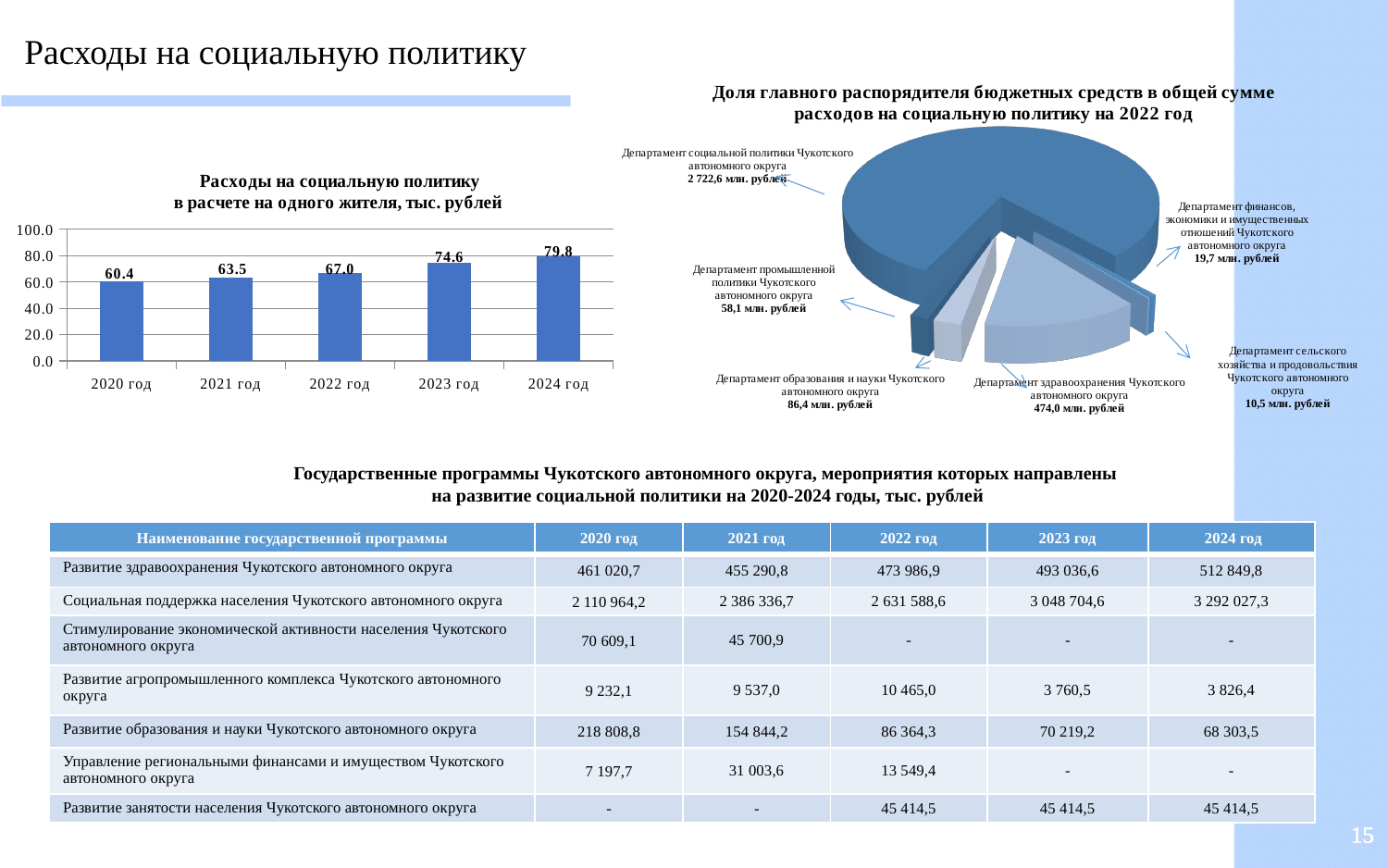
How many years are shown in the bar chart 'Расходы на социальную политику в расчете на одного жителя, тыс. рублей'? 5 In the bar chart 'Расходы на социальную политику в расчете на одного жителя, тыс. рублей', what is the difference between the values for 2024 год and 2020 год? 19.4 In the bar chart 'Расходы на социальную политику в расчете на одного жителя, тыс. рублей', what is the value for 2023 год? 74.6 What kind of chart is 'Расходы на социальную политику в расчете на одного жителя, тыс. рублей'? bar chart In the pie chart 'Доля главного распорядителя бюджетных средств в общей сумме расходов на социальную политику на 2022 год', what is the value for Департамент здравоохранения Чукотского автономного округа? 474,0 млн. рублей In the bar chart 'Расходы на социальную политику в расчете на одного жителя, тыс. рублей', which year has the lowest value? 2020 год In the bar chart 'Расходы на социальную политику в расчете на одного жителя, тыс. рублей', what is the value for 2020 год? 60.4 In the pie chart 'Доля главного распорядителя бюджетных средств в общей сумме расходов на социальную политику на 2022 год', which department has the smallest value? Департамент сельского хозяйства и продовольствия Чукотского автономного округа In the bar chart 'Расходы на социальную политику в расчете на одного жителя, тыс. рублей', which year has the highest value? 2024 год In the pie chart 'Доля главного распорядителя бюджетных средств в общей сумме расходов на социальную политику на 2022 год', which is larger: the value for Департамент образования и науки or for Департамент промышленной политики? Департамент образования и науки In the bar chart 'Расходы на социальную политику в расчете на одного жителя, тыс. рублей', do the values rise or fall from 2020 год to 2024 год? rise In the pie chart 'Доля главного распорядителя бюджетных средств в общей сумме расходов на социальную политику на 2022 год', what is the value for Департамент социальной политики Чукотского автономного округа? 2 722,6 млн. рублей